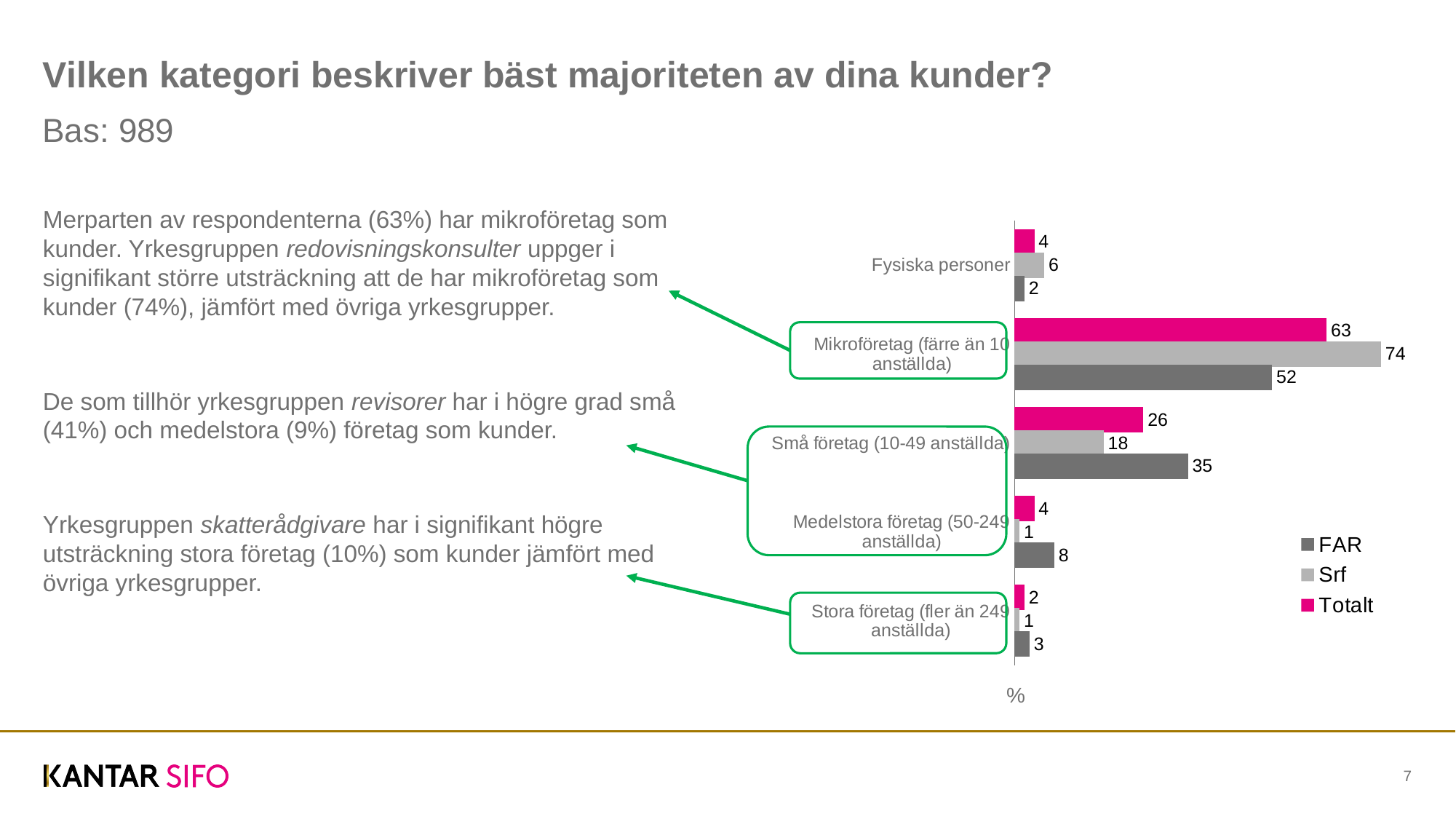
How many categories are shown on the chart? 5 What is the Totalt value for Mikroföretag (färre än 10 anställda)? 63 What is the Srf value for Små företag (10-49 anställda)? 18 How many series does the legend list? 3 Which colour represents the Totalt series in the chart? Pink Which category has the highest Totalt value? Mikroföretag (färre än 10 anställda) What is the Srf value for Fysiska personer? 6 What kind of chart is shown on the slide? Bar chart What is the FAR value for Medelstora företag (50-249 anställda)? 8 For Små företag (10-49 anställda), which series has the larger value, FAR or Srf? FAR What is the difference between the Srf and FAR values for Mikroföretag (färre än 10 anställda)? 22 Which category has the lowest FAR value? Fysiska personer